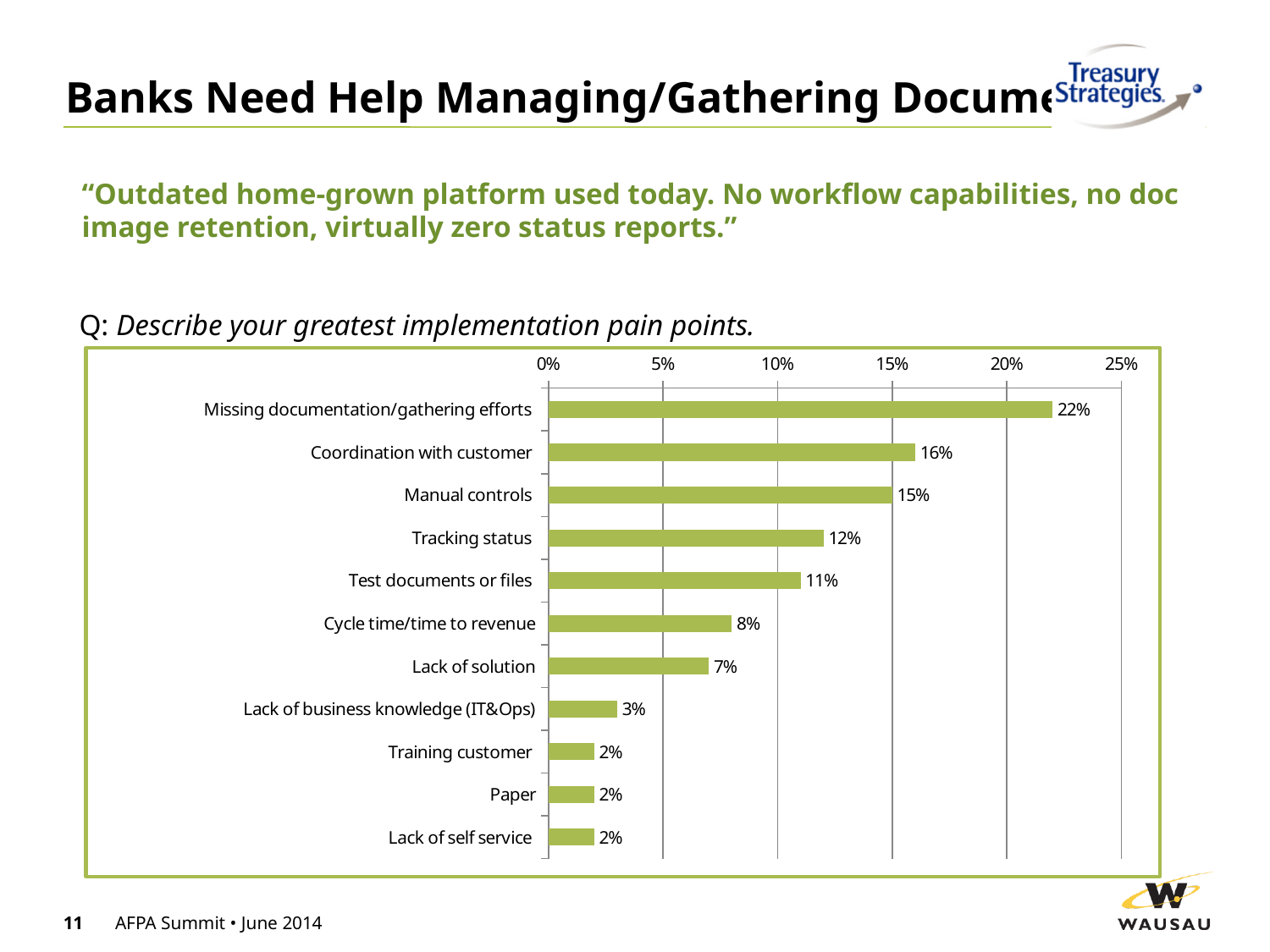
What is the maximum value shown on the percentage axis? 25% What is the value for Coordination with customer? 16% Is the value for Manual controls greater or less than 10%? greater What is the difference between Missing documentation/gathering efforts and Coordination with customer? 6% What percentage of respondents cited Missing documentation/gathering efforts as a pain point? 22% What is the value for Lack of business knowledge (IT&Ops)? 3% Which is larger, Test documents or files or Lack of solution? Test documents or files What kind of chart is shown on the slide? Bar chart What is the value for Cycle time/time to revenue? 8% What is the difference between Manual controls and Tracking status? 3% How many pain point categories are shown in the chart? 11 Which pain point has the highest percentage? Missing documentation/gathering efforts